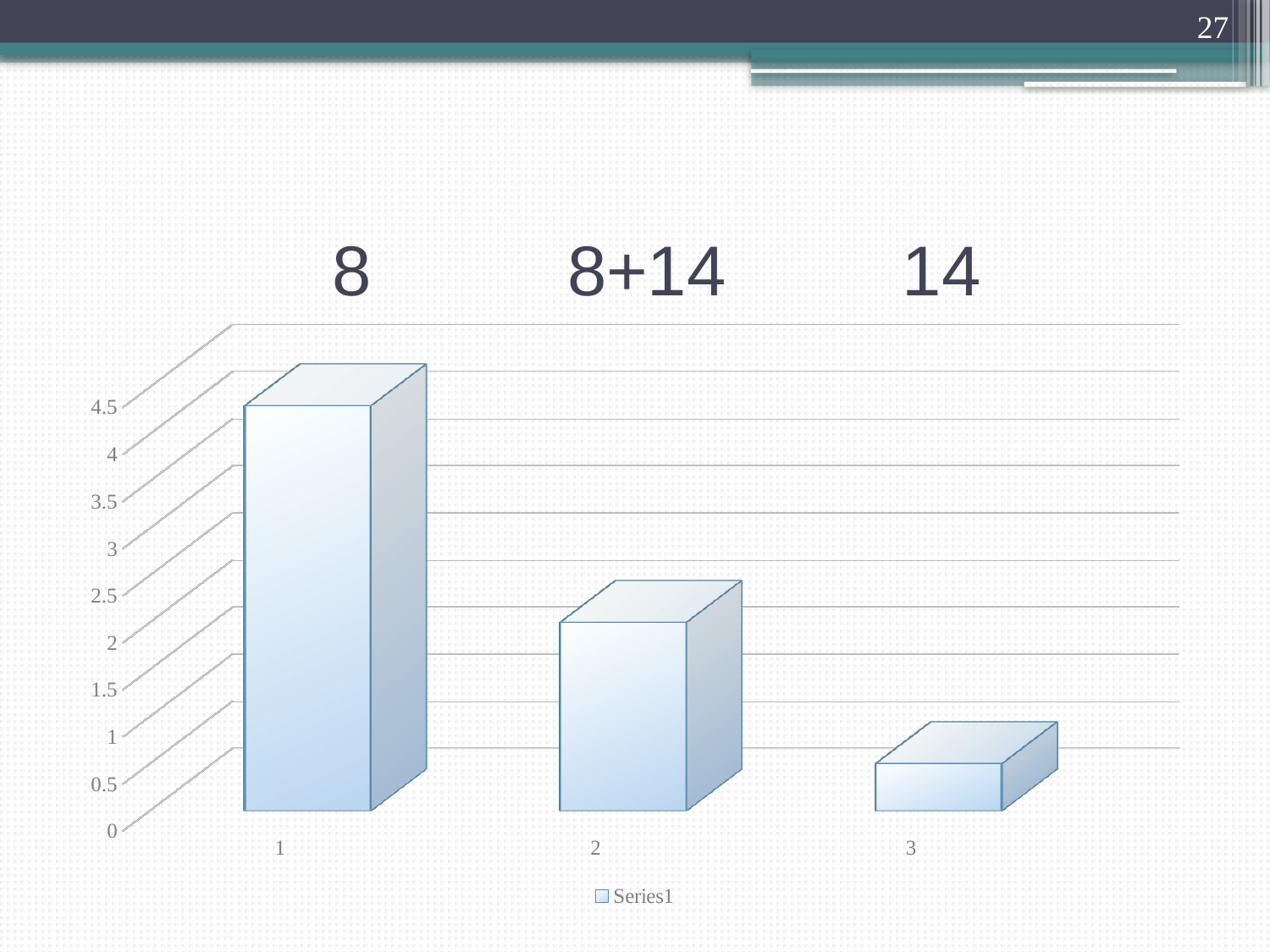
Which category has the tallest bar? 1 Is the value for category 1 greater or less than 4? greater How many bars (categories) does the chart show? 3 Is the value for category 2 greater or less than 3? less Which bar is taller, category 2 or category 3? 2 What is the name of the series shown in the legend? Series1 Is the value for category 3 greater or less than 1? less Which bar is taller, category 1 or category 2? 1 Do the bar values rise or fall from category 1 to category 3? fall Which category has the shortest bar? 3 How many series does the legend list? 1 What kind of chart is shown on the slide? bar chart